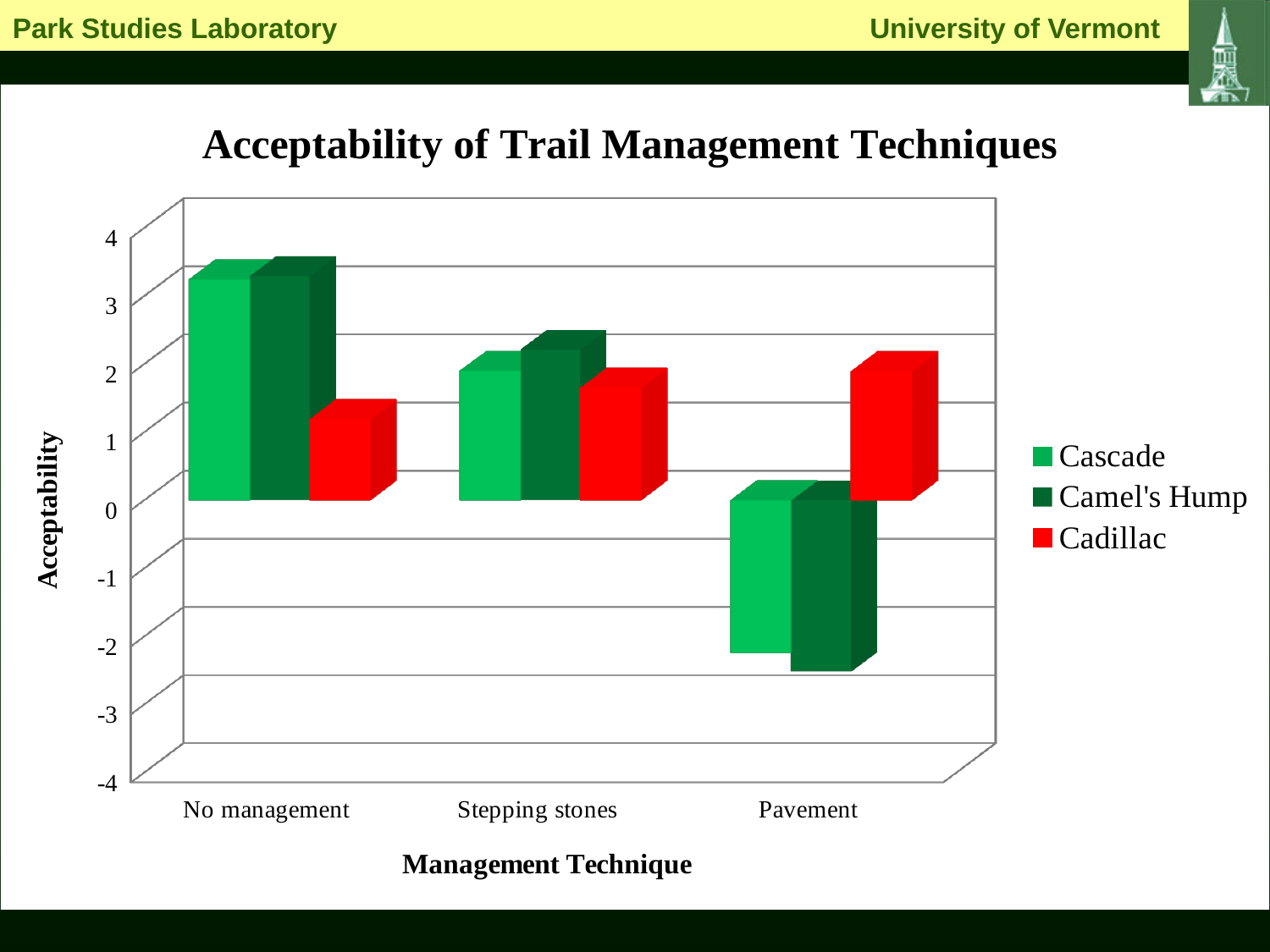
Which is larger for Cascade: the value for No management or the value for Pavement? No management Is the Camel's Hump value for Pavement greater or less than -1? less What is the title of the x axis? Management Technique Which management technique has the highest acceptability for Cascade? No management Is the Cadillac value for Pavement greater or less than 1? greater How many management techniques are shown on the x axis? 3 What kind of chart is shown on the slide? Bar chart Is the Cadillac value for No management greater or less than 2? less Which management technique has the lowest acceptability for Cadillac? No management Do the Cascade values rise or fall from No management to Pavement along the x axis? fall How many series does the legend list? 3